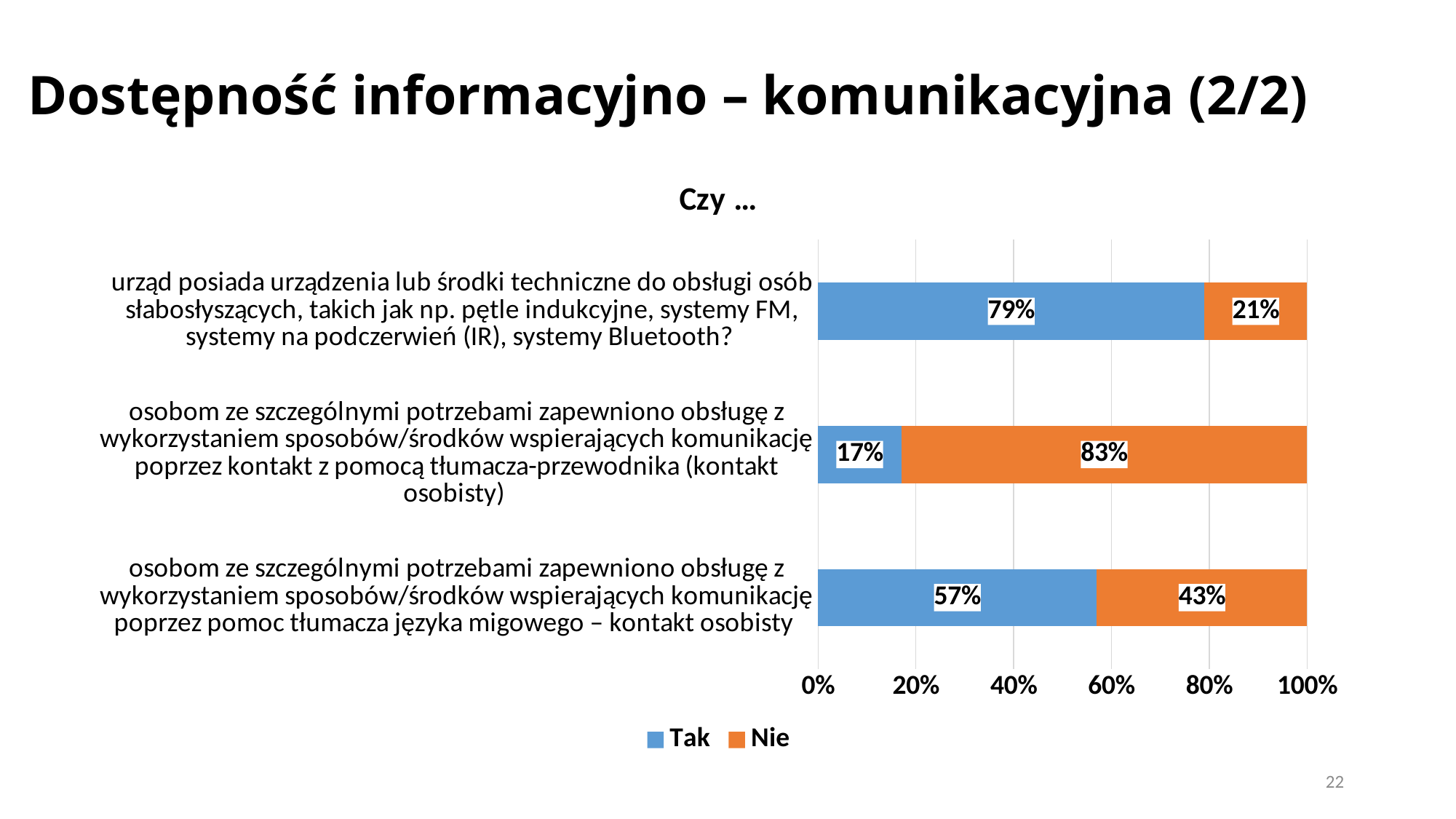
Which category has the highest "Tak" value? urząd posiada urządzenia lub środki techniczne do obsługi osób słabosłyszących Which category has the lowest "Tak" value? osobom ze szczególnymi potrzebami zapewniono obsługę z wykorzystaniem sposobów/środków wspierających komunikację poprzez kontakt z pomocą tłumacza-przewodnika (kontakt osobisty) What is the "Tak" value for the category about service with the help of a sign language interpreter (tłumacza języka migowego)? 57% What kind of chart is shown on the slide? stacked bar chart Is the "Tak" value larger for the guide-interpreter category or for the sign language interpreter category? sign language interpreter category (57%) What is the title of the chart? Czy … What is the difference between the "Tak" and "Nie" values for the sign language interpreter category? 14% How many categories are shown in the chart? 3 What is the "Tak" value for the category about devices for people with hearing impairments (induction loops, FM systems, IR, Bluetooth)? 79% How many series does the legend list? 2 What is the "Nie" value for the category about devices for people with hearing impairments? 21% What is the "Nie" value for the category about service with the help of a guide-interpreter (tłumacza-przewodnika, kontakt osobisty)? 83%